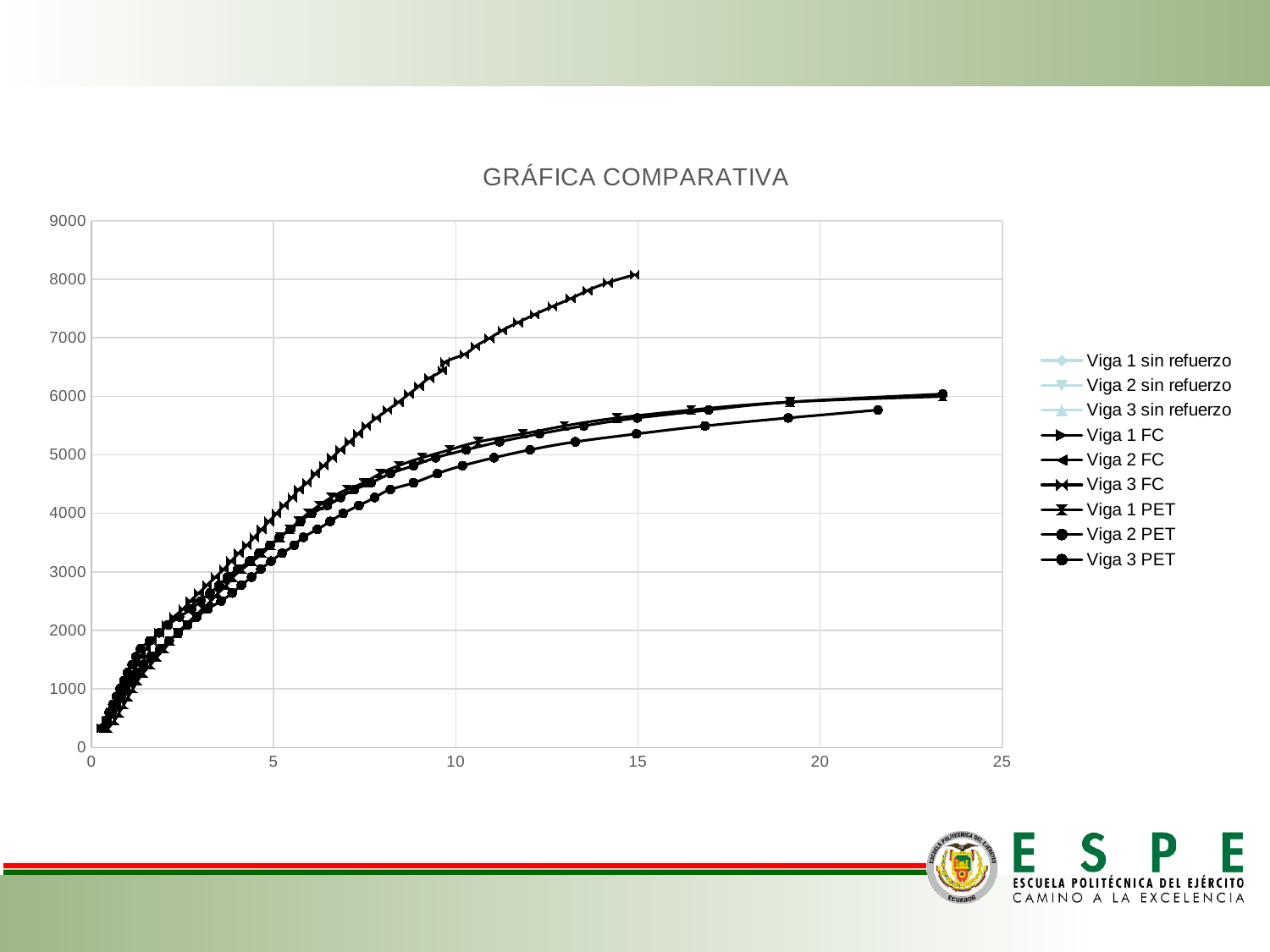
Do the values of the Viga 3 FC series rise or fall as the x axis increases? rise What is the highest value shown on the vertical axis? 9000 How many series does the legend list? 9 Is the x value at which the Viga 3 FC series ends greater or less than 20? less Is the highest value reached by the Viga 3 FC series greater or less than 7000? greater At x = 10, which series has the larger value, Viga 3 FC or Viga 2 PET? Viga 3 FC What kind of chart is shown on the slide? line chart What is the title of the chart? GRÁFICA COMPARATIVA Is the value of the Viga 3 FC series at x = 10 greater or less than 6000? greater Which series reaches the highest value on the chart? Viga 3 FC